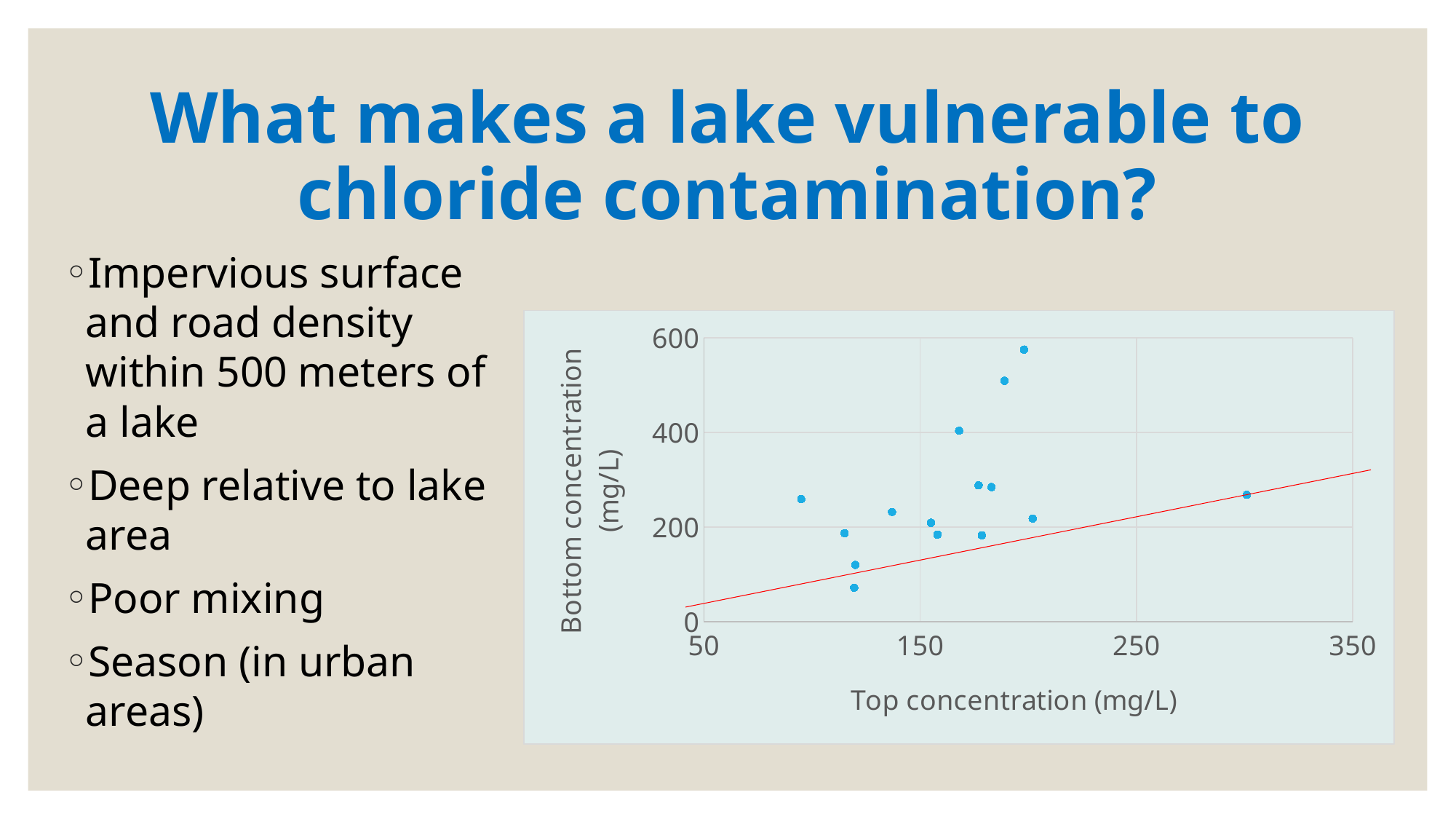
Is the bottom concentration of the highest point on the chart greater or less than 400 mg/L? greater Does the red trend line on the chart rise or fall as top concentration increases? rises Is the bottom concentration of the lowest point on the chart greater or less than 200 mg/L? less Is the top concentration of the leftmost point on the chart greater or less than 150 mg/L? less How many data points are plotted on the chart? 15 What is the label of the y axis of the chart? Bottom concentration (mg/L) What is the highest value shown on the y axis of the chart? 600 What kind of chart is shown on the slide? scatter chart What is the label of the x axis of the chart? Top concentration (mg/L)